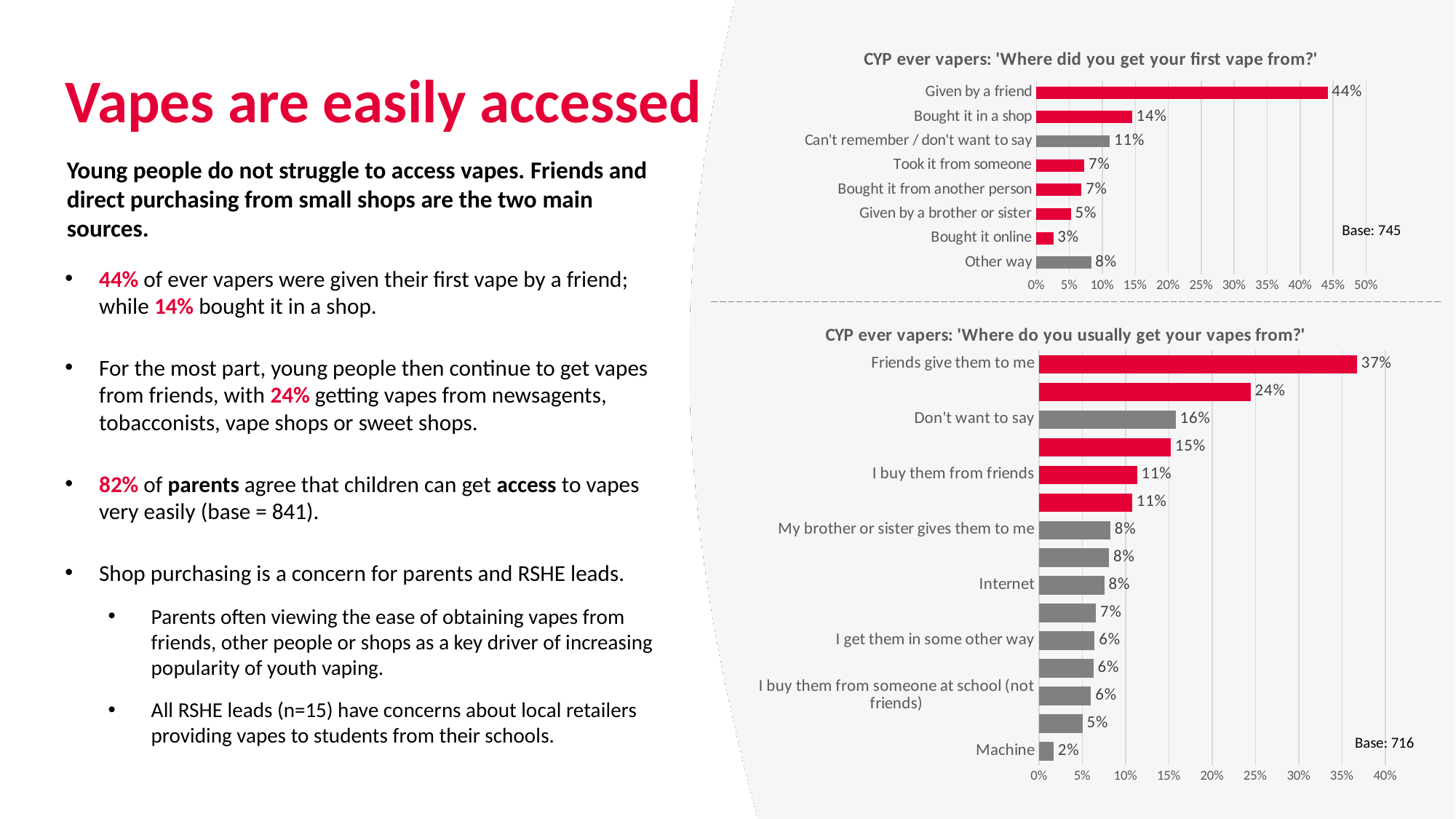
In the chart 'Where do you usually get your vapes from?', how many bars are plotted? 15 In the chart 'Where did you get your first vape from?', how many categories are shown? 8 In the chart 'Where did you get your first vape from?', which category has the lowest value? Bought it online In the chart 'Where did you get your first vape from?', what is the value for 'Bought it online'? 3% In the chart 'Where do you usually get your vapes from?', what is the value for 'Friends give them to me'? 37% In the chart 'Where did you get your first vape from?', what percentage were given their first vape by a friend? 44% In the chart 'Where did you get your first vape from?', what is the difference between 'Given by a friend' and 'Bought it in a shop'? 30 percentage points In the chart 'Where do you usually get your vapes from?', which is larger: 'Don't want to say' or 'I buy them from friends'? Don't want to say What type of chart is the chart 'Where do you usually get your vapes from?'? Bar chart In the chart 'Where did you get your first vape from?', which category has the highest value? Given by a friend In the chart 'Where do you usually get your vapes from?', what is the value for 'Machine'? 2% In the chart 'Where did you get your first vape from?', what is the base size shown? 745